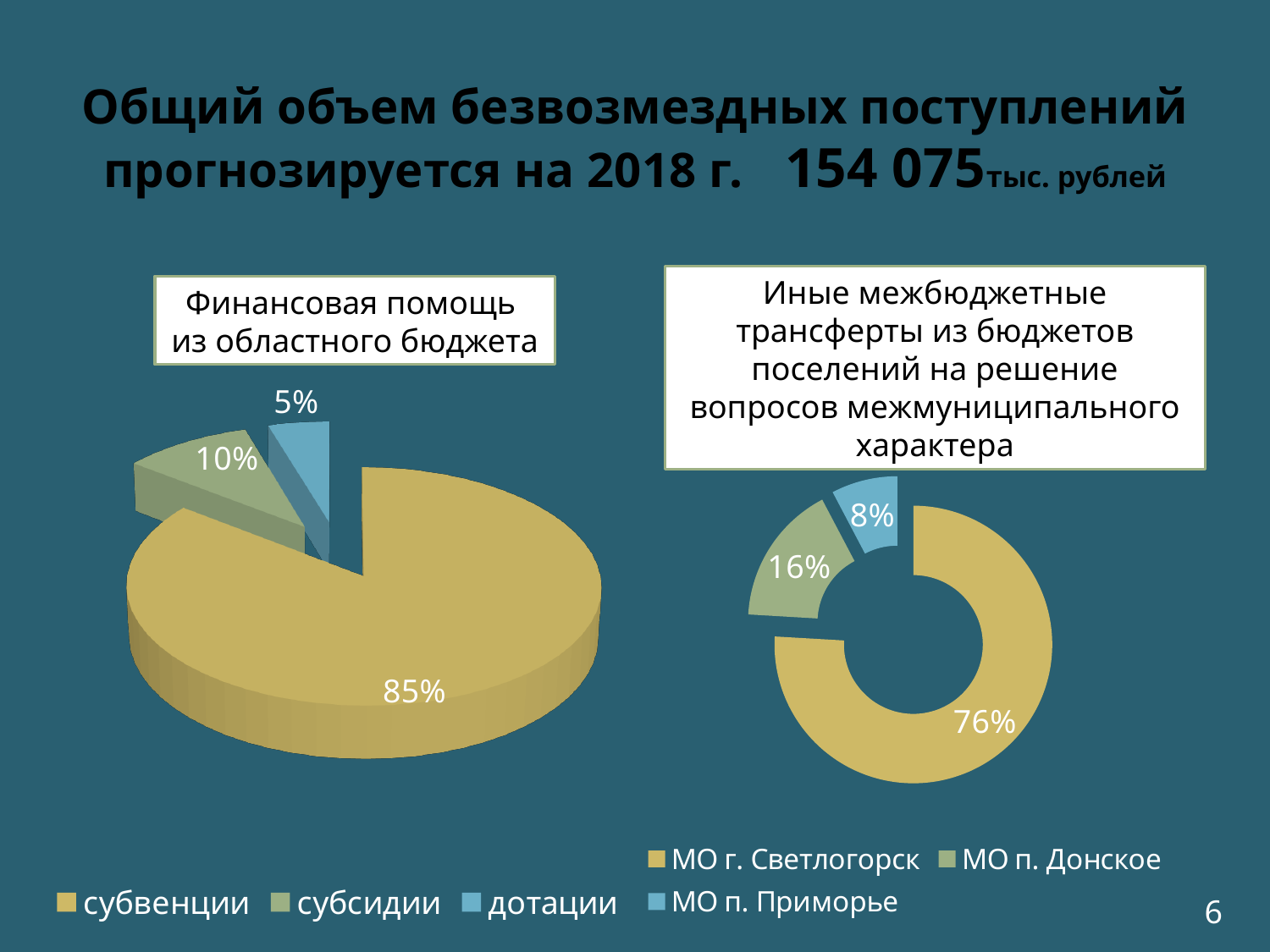
In the left chart (Финансовая помощь из областного бюджета), what share do дотации have? 5% In the right chart (Иные межбюджетные трансферты), what share does МО г. Светлогорск have? 76% In the right chart (Иные межбюджетные трансферты), what share does МО п. Приморье have? 8% In the right chart (Иные межбюджетные трансферты), what share does МО п. Донское have? 16% In the left chart (Финансовая помощь из областного бюджета), which category has the largest share? субвенции In the right chart (Иные межбюджетные трансферты), which is larger: the share of МО п. Донское or МО п. Приморье? МО п. Донское How many categories does the legend of the right chart (Иные межбюджетные трансферты) list? 3 In the left chart (Финансовая помощь из областного бюджета), what share do субсидии have? 10% In the right chart (Иные межбюджетные трансферты), what is the difference between the shares of МО г. Светлогорск and МО п. Донское? 60% In the left chart (Финансовая помощь из областного бюджета), what is the difference between the shares of субсидии and дотации? 5% In the left chart (Финансовая помощь из областного бюджета), which category has the smallest share? дотации In the left chart (Финансовая помощь из областного бюджета), what share do субвенции have? 85%